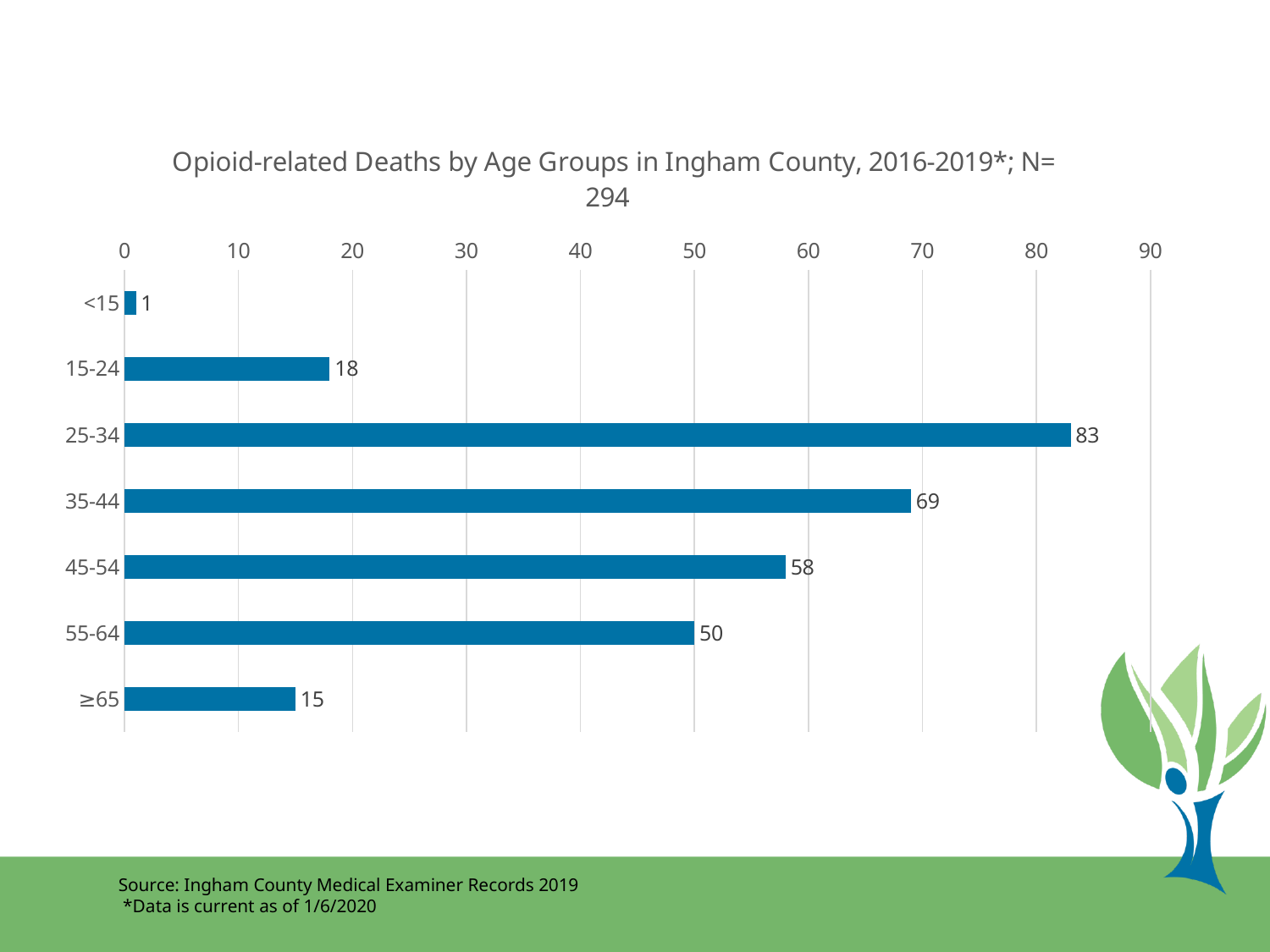
Which age group has the lowest number of opioid-related deaths? <15 What is the title of the chart? Opioid-related Deaths by Age Groups in Ingham County, 2016-2019*; N= 294 Which age group has the highest number of opioid-related deaths? 25-34 What is the number of opioid-related deaths for the 25-34 age group? 83 What is the number of opioid-related deaths for the 55-64 age group? 50 How many age groups are shown in the chart? 7 What is the number of opioid-related deaths for the ≥65 age group? 15 Which age group has more opioid-related deaths, 15-24 or ≥65? 15-24 What is the difference in opioid-related deaths between the 35-44 and 45-54 age groups? 11 What kind of chart is shown on the slide? Bar chart What is the source cited for the chart data? Ingham County Medical Examiner Records 2019 Is the value for the 45-54 age group greater or less than 60? less